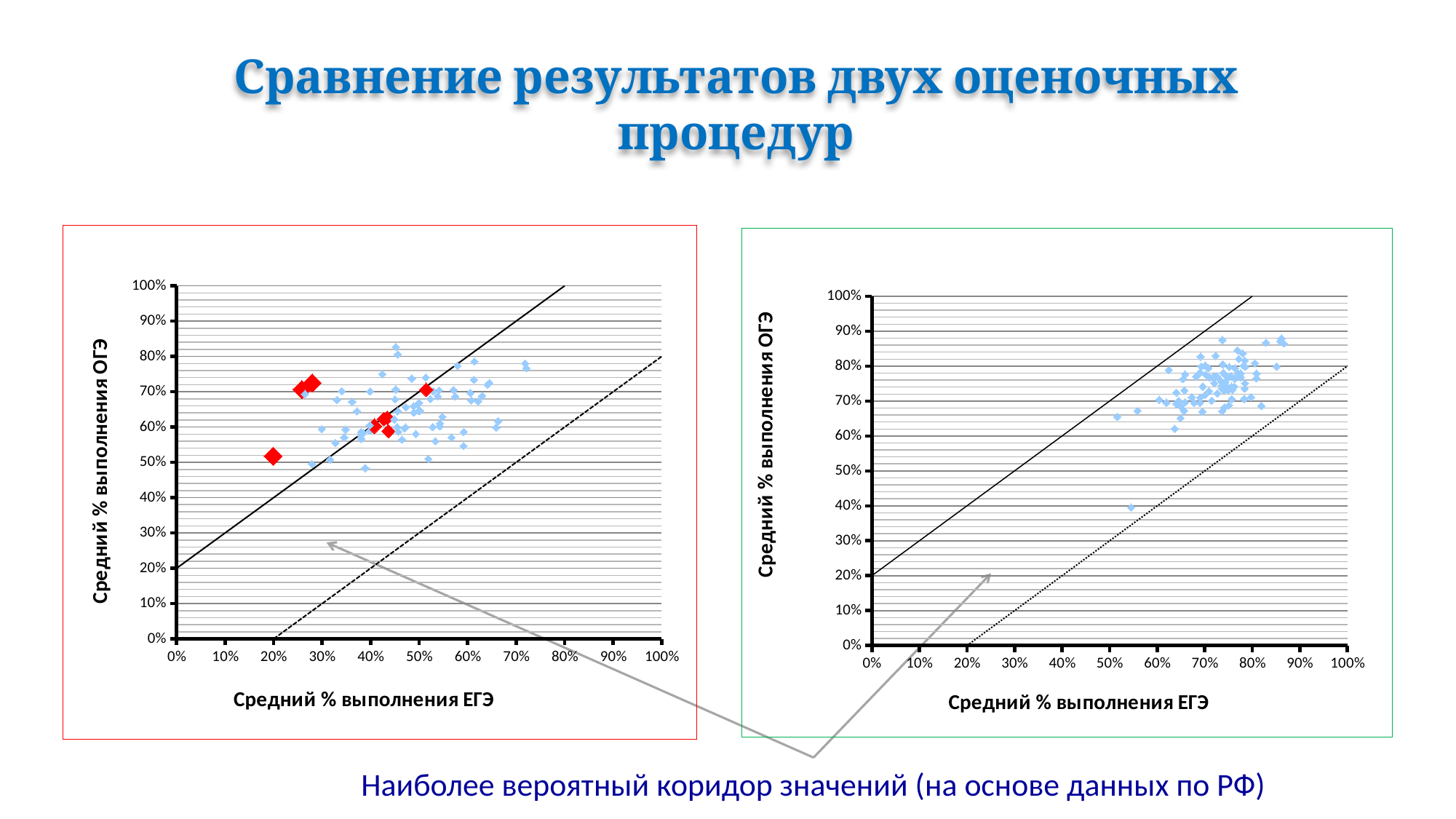
What is the maximum value shown on the y-axis of the right chart? 100% In the left chart, is the y-value of the red diamond located at about 25% on the x-axis greater or less than 60%? greater In the left chart, which red diamond has the higher y-value: the one at about 20% on the x-axis or the one at about 50% on the x-axis? the one at about 50% In the right chart, is the y-value of the lowest point greater or less than 50%? less In the left chart, is the y-value of the red diamond located at about 20% on the x-axis greater or less than 40%? greater In the right chart, at what x-value does the dotted line reach 0% on the y-axis? 20% How many charts are shown on the slide? 2 What is the y-axis title of the left chart? Средний % выполнения ОГЭ What is the x-axis title of the right chart? Средний % выполнения ЕГЭ What kind of chart is the left chart? scatter chart In the left chart, at what y-value does the solid line cross the y-axis (x = 0%)? 20%